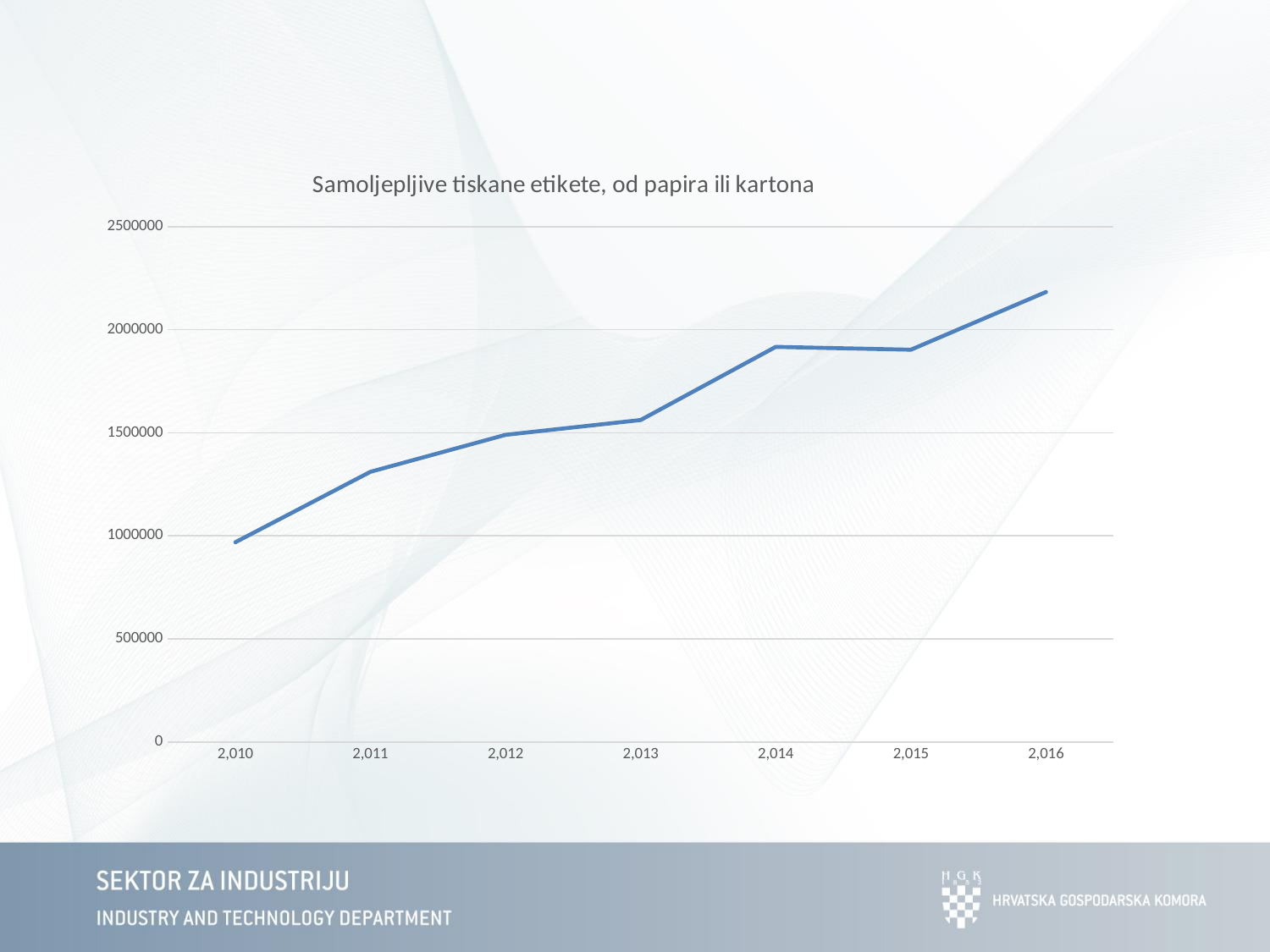
Which year has the lowest value? 2,010 Is the value for 2,013 greater or less than 1500000? greater What kind of chart is shown on the slide? line chart Which year has the highest value? 2,016 How many years are plotted along the x axis? 7 What is the title of the chart? Samoljepljive tiskane etikete, od papira ili kartona Which is larger, the value for 2,012 or the value for 2,010? 2,012 Is the value for 2,016 greater or less than 2000000? greater Which is larger, the value for 2,011 or the value for 2,014? 2,014 Is the value for 2,014 greater or less than 2000000? less Do the values generally rise or fall from 2,010 to 2,016? rise